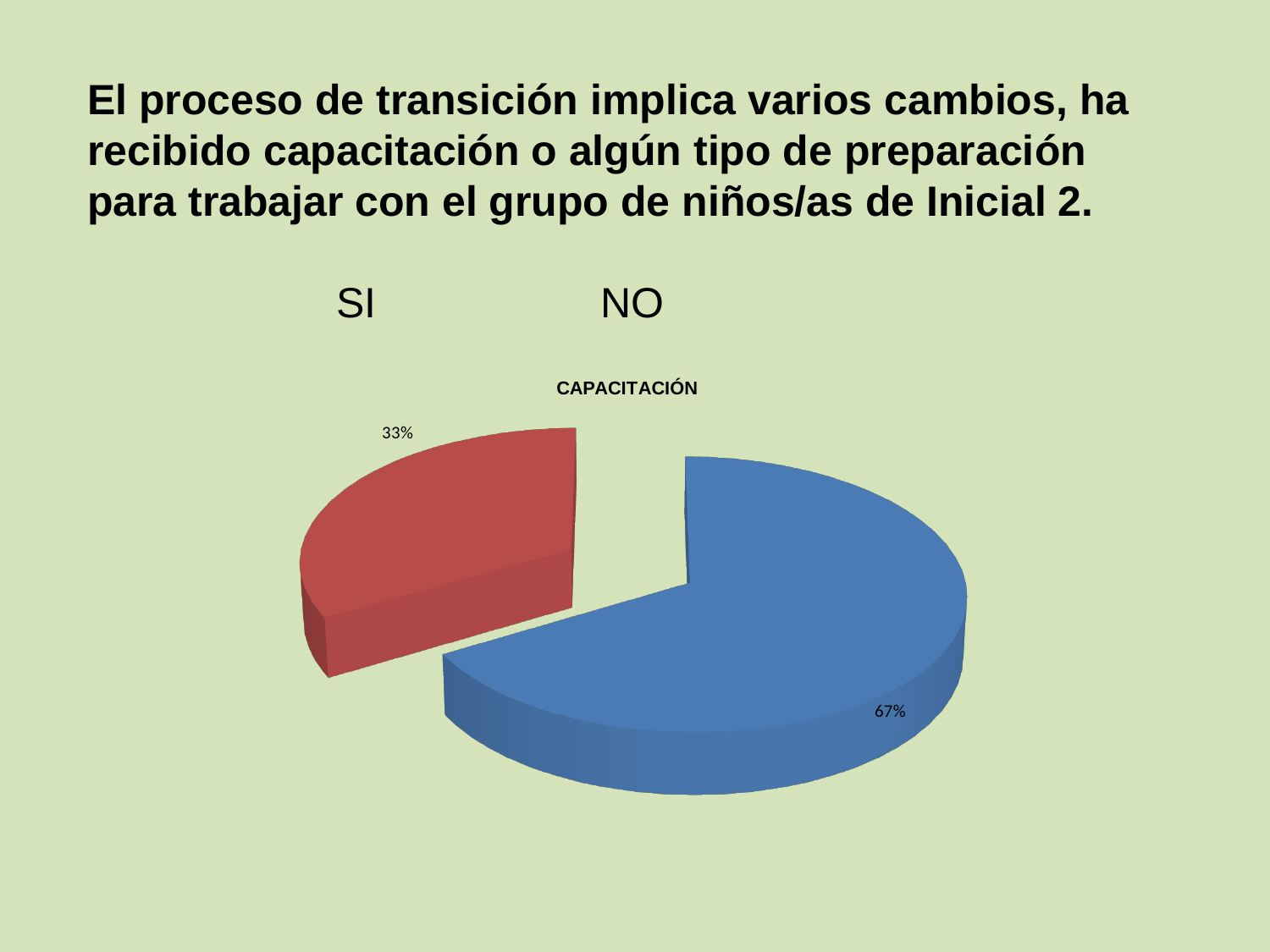
Which slice of the pie chart is the smallest? The red slice (33%) What is the title of the chart? CAPACITACIÓN What two colours are used for the slices of the pie chart? Red and blue Which is larger, the blue slice or the red slice? The blue slice What kind of chart is shown on the slide? Pie chart What percentage is shown for the red slice of the pie chart? 33% What is the difference in percentage points between the blue slice and the red slice? 34 percentage points How many slices does the pie chart have? 2 What share of the pie does the red slice represent? 33% Is the value of the blue slice greater or less than 50%? greater What percentage is shown for the blue slice of the pie chart? 67% Which slice of the pie chart is the largest? The blue slice (67%)